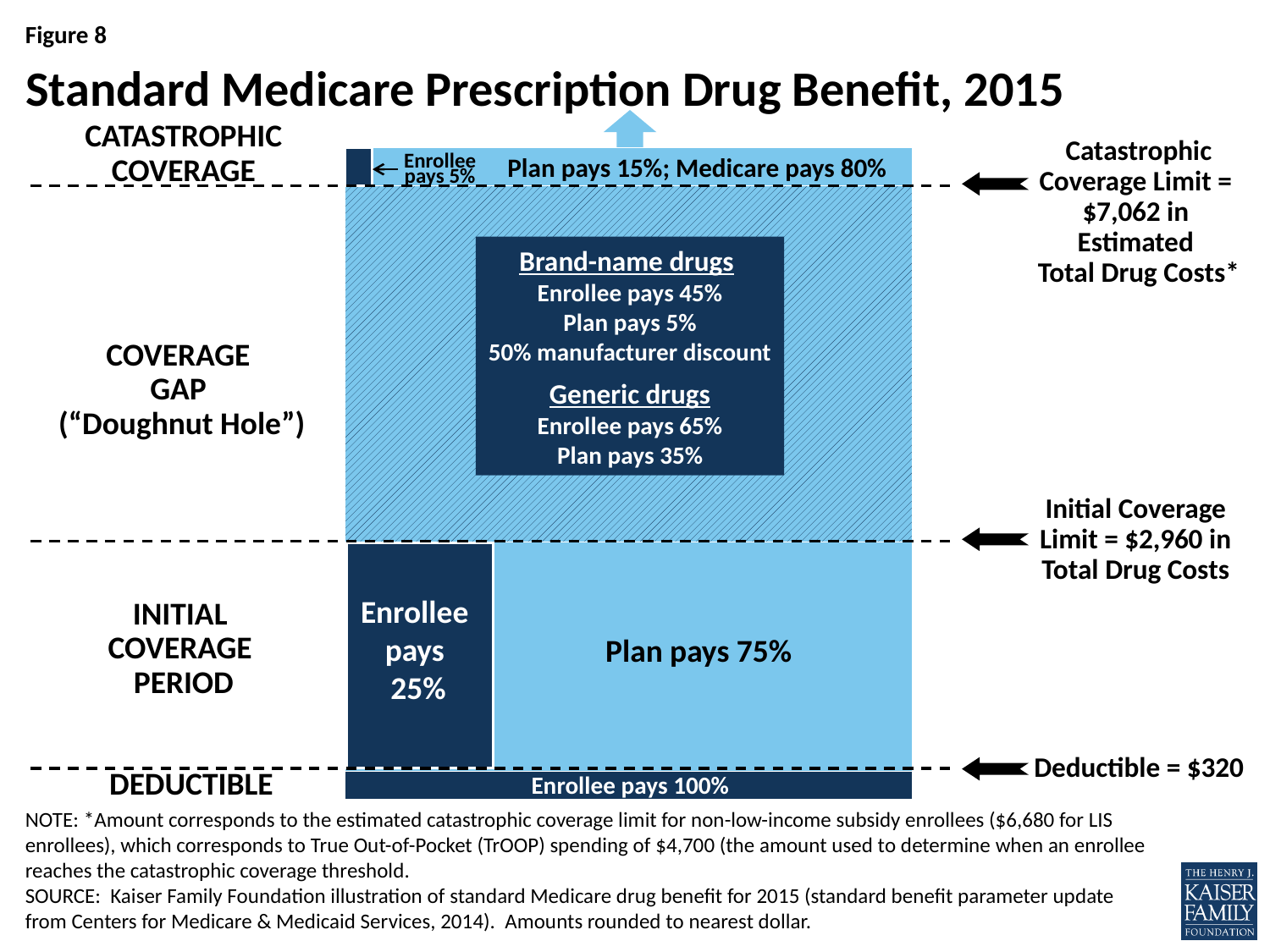
In the coverage gap, is the enrollee's share larger for brand-name drugs or generic drugs? Generic drugs What is the title of the figure? Standard Medicare Prescription Drug Benefit, 2015 In the coverage gap, what percentage does the plan pay for generic drugs? 35% What is the Catastrophic Coverage Limit in estimated total drug costs? $7,062 What is the deductible amount shown on the slide? $320 In the coverage gap, what percentage does the enrollee pay for brand-name drugs? 45% What is the difference between the Initial Coverage Limit and the deductible? $2,640 What is the Initial Coverage Limit in total drug costs? $2,960 During the initial coverage period, what percentage does the plan pay? 75% What percentage does the enrollee pay in the deductible phase? 100% During the initial coverage period, what percentage does the enrollee pay? 25% In catastrophic coverage, what percentage does Medicare pay? 80%